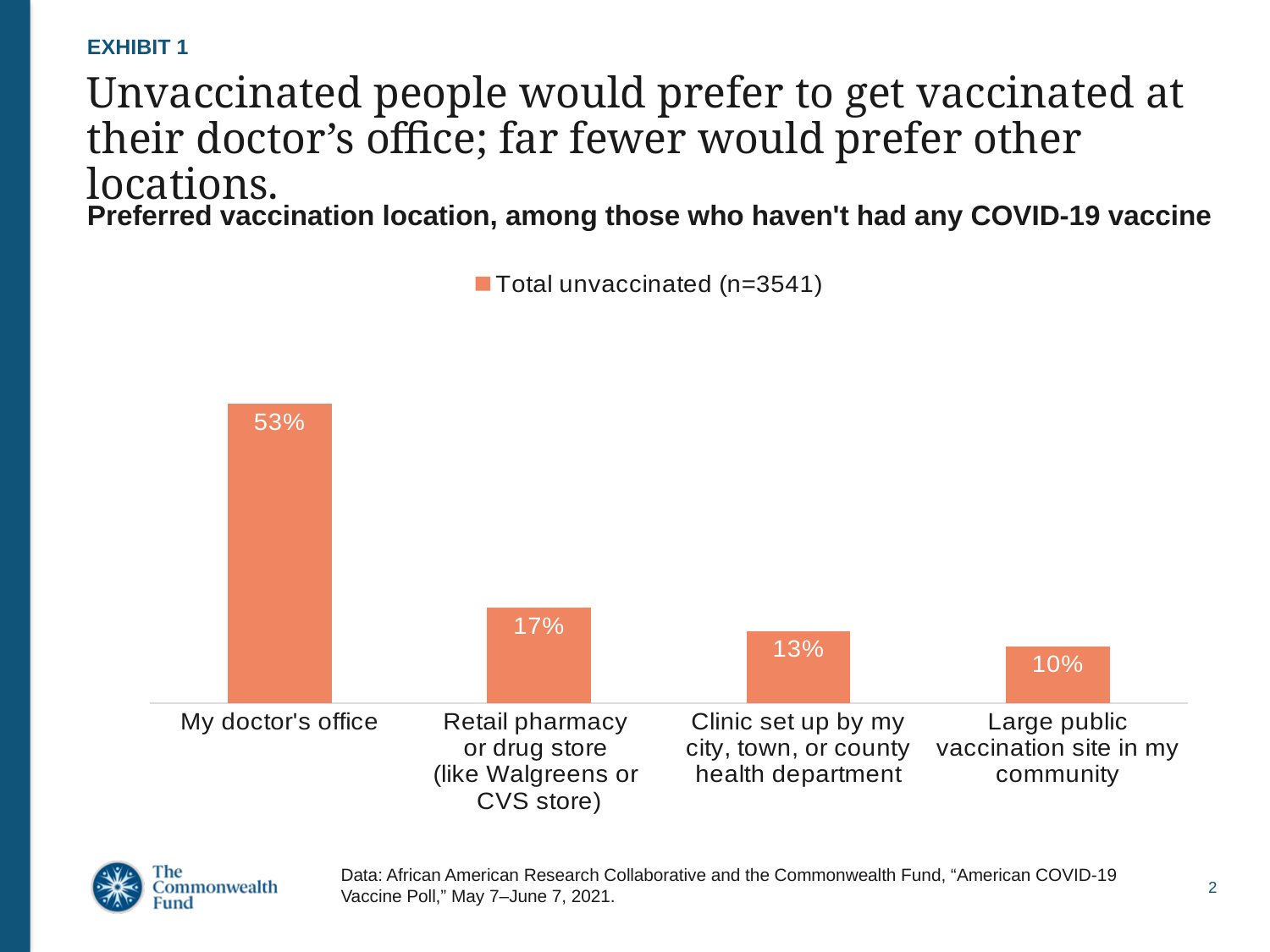
What percentage of unvaccinated people prefer to get vaccinated at their doctor's office? 53% Which is larger: the value for 'Clinic set up by my city, town, or county health department' or the value for 'Large public vaccination site in my community'? Clinic set up by my city, town, or county health department How many vaccination location categories are shown in the chart? 4 Which preferred vaccination location has the highest value? My doctor's office What kind of chart is shown on the slide? Bar chart What is the difference between the value for 'My doctor's office' and the value for 'Retail pharmacy or drug store'? 36 percentage points Which preferred vaccination location has the lowest value? Large public vaccination site in my community How many series does the legend list? 1 What is the legend entry shown above the chart? Total unvaccinated (n=3541) What is the value for 'Retail pharmacy or drug store (like Walgreens or CVS store)'? 17% What is the value for 'Large public vaccination site in my community'? 10% What is the value for 'Clinic set up by my city, town, or county health department'? 13%